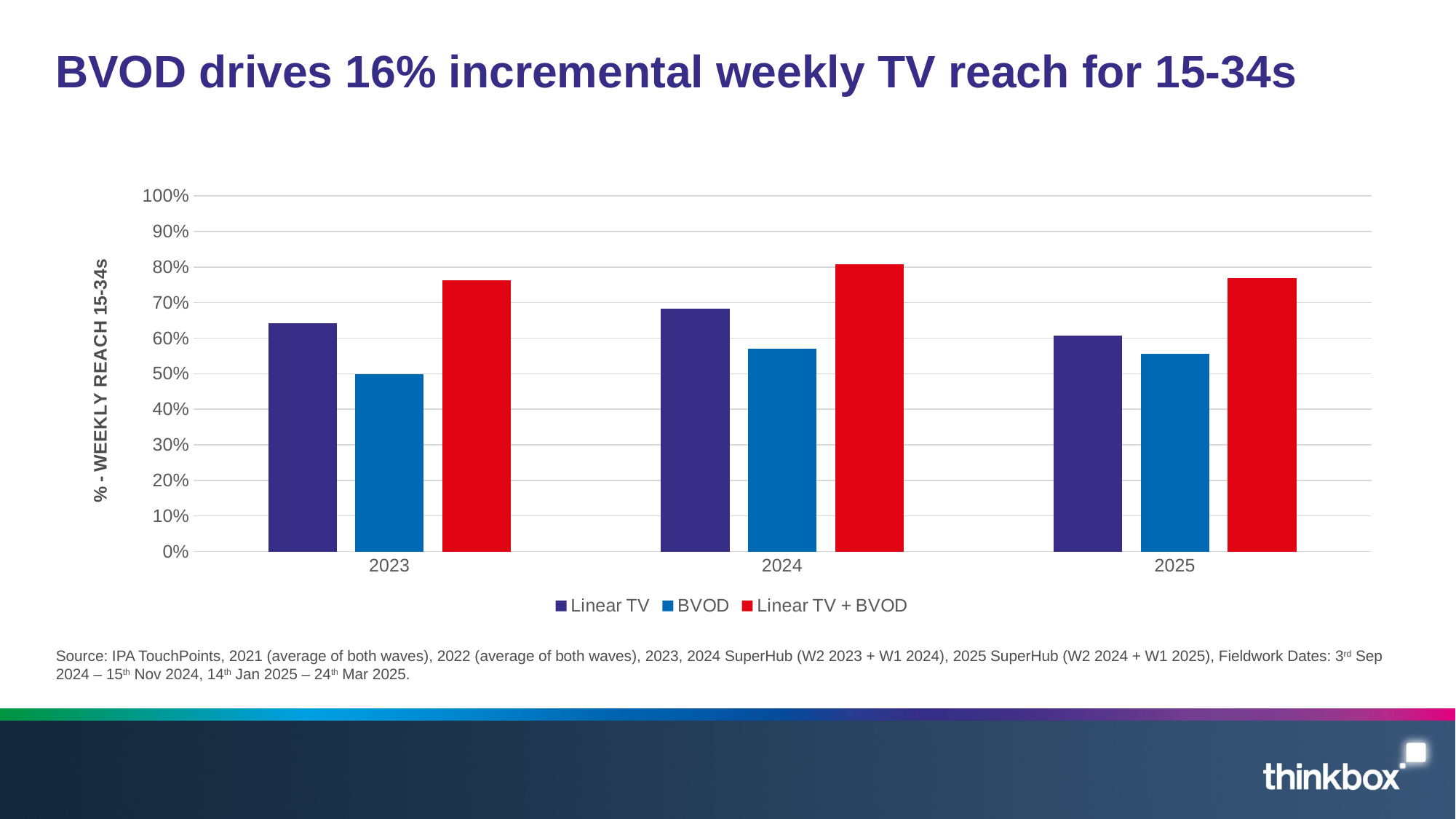
Is the value for Linear TV + BVOD in 2024 greater or less than 70%? greater Is the value for BVOD in 2024 greater or less than 60%? less What colour are the BVOD bars in the chart? Blue Is the value for Linear TV in 2025 greater or less than 50%? greater Which is larger, the Linear TV reach in 2023 or in 2024? 2024 How many series does the chart's legend list? 3 What is the title of the slide? BVOD drives 16% incremental weekly TV reach for 15-34s How many years are shown on the x axis of the chart? 3 In which year is the BVOD weekly reach lowest? 2023 In which year is the Linear TV + BVOD weekly reach highest? 2024 What kind of chart is shown on the slide? Bar chart Does the Linear TV reach rise or fall from 2024 to 2025? fall